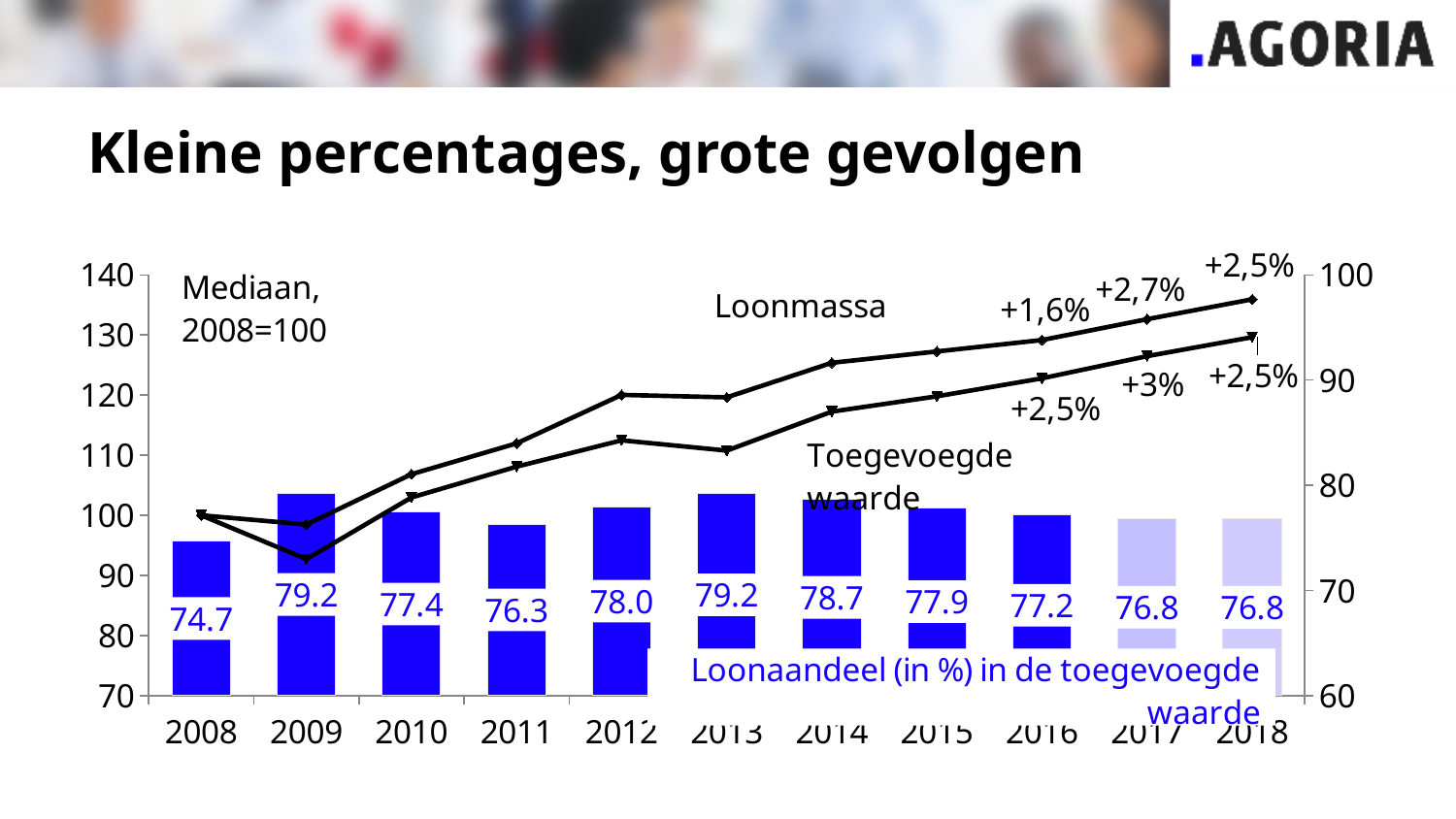
In which year is the Loonaandeel (in %) bar the lowest? 2008 What percentage change is labelled for Loonmassa in 2017? +2,7% Does the Loonmassa line rise or fall from 2009 to 2018? Rises What is the Loonaandeel (in %) value shown for 2008? 74.7 What kind of chart is shown on the slide? Combined bar and line chart Which year has a higher Loonaandeel value, 2014 or 2016? 2014 What is the Loonaandeel (in %) value shown for 2013? 79.2 What is the Loonaandeel (in %) value shown for 2018? 76.8 What is the title of the slide? Kleine percentages, grote gevolgen How many years are shown on the x axis of the chart? 11 Is the Loonmassa value for 2018 greater or less than 130 on the left axis? greater What is the difference between the Loonaandeel values for 2009 and 2008? 4.5